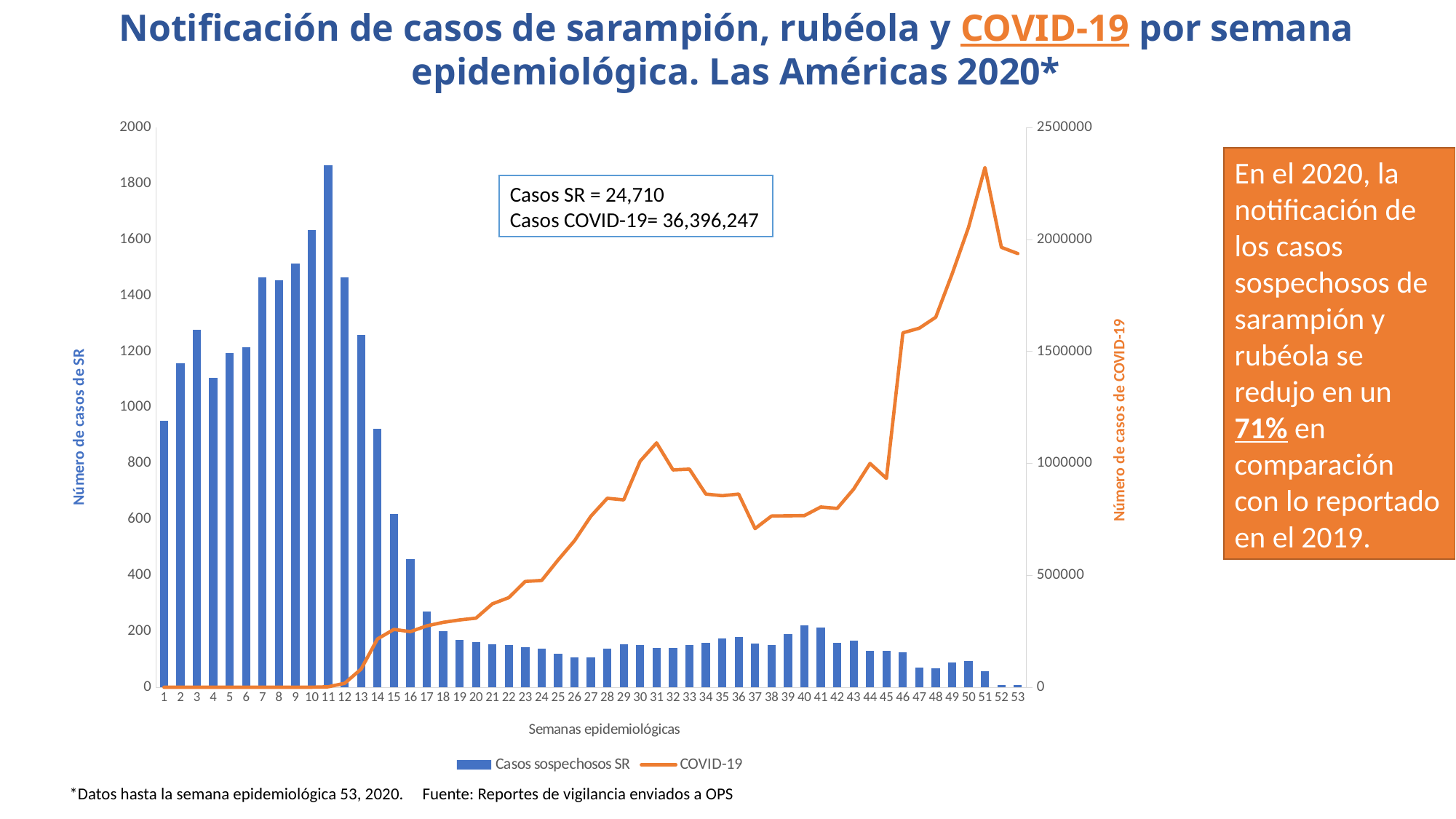
Is the number of COVID-19 cases in week 51 greater or less than 2000000? greater How many epidemiological weeks are plotted along the x axis? 53 Is the number of COVID-19 cases in week 37 greater or less than 1000000? less How many series does the legend list? 2 Is the number of suspected SR cases in week 11 greater or less than 1600? greater Do the suspected SR cases rise or fall from week 11 to week 17? fall In which epidemiological week does the COVID-19 line reach its highest value? Week 51 Which week has more suspected SR cases, week 3 or week 11? Week 11 In which epidemiological week is the number of suspected SR cases (Casos sospechosos SR) highest? Week 11 According to the text box on the chart, what is the total number of COVID-19 cases? 36,396,247 What kind of chart is shown on the slide? A combined bar and line chart